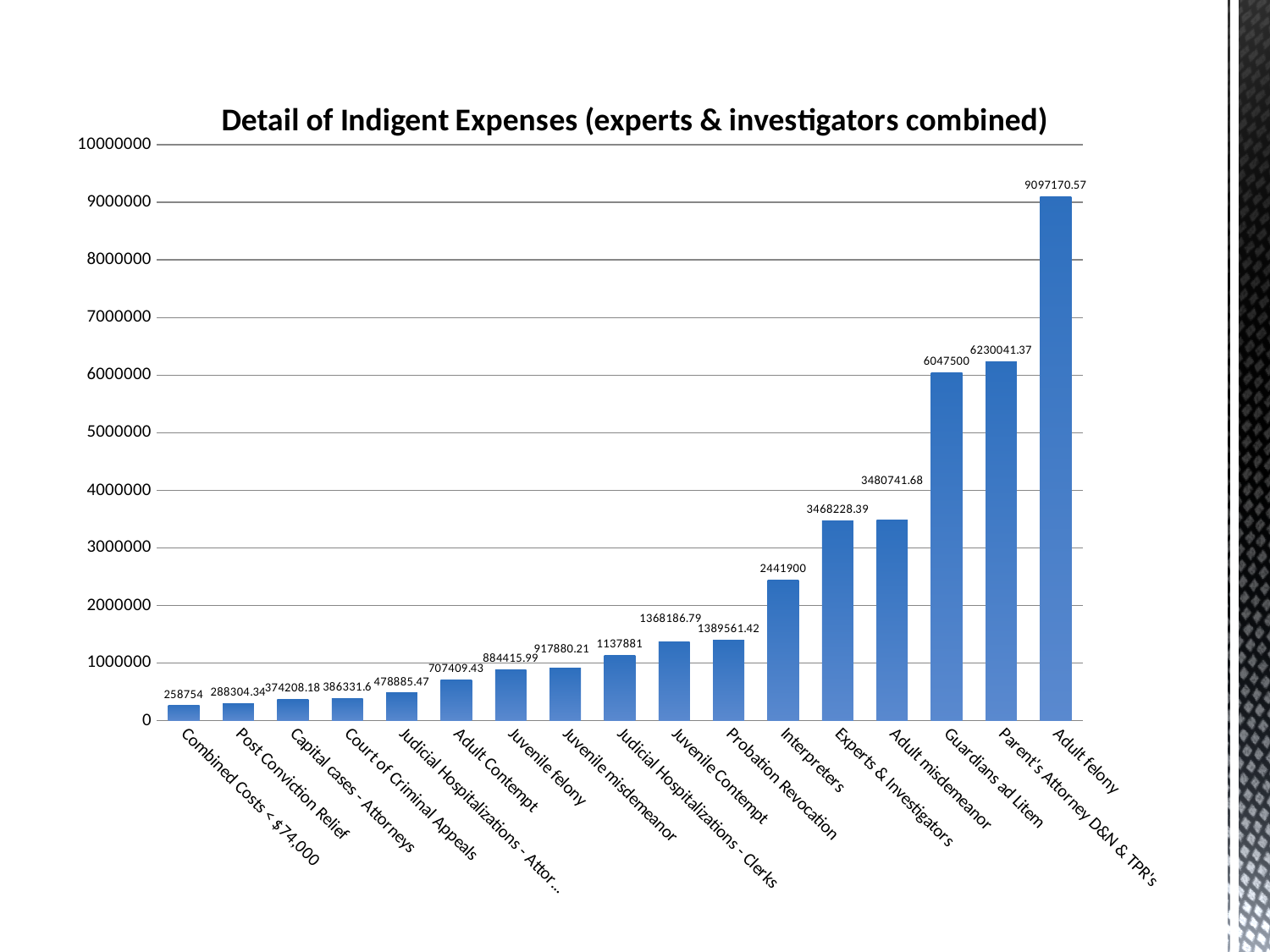
Do the values rise or fall from left to right along the x axis? rise What is the value for Post Conviction Relief? 288304.34 What is the value for Adult felony? 9097170.57 What is the value for Guardians ad Litem? 6047500 How many categories are shown on the x axis? 17 Which category has the lowest value? Combined Costs < $74,000 What is the difference between the values for Adult felony and Guardians ad Litem? 3049670.57 What is the value for Interpreters? 2441900 What kind of chart is this? bar chart Which category has the highest value? Adult felony Which is larger, the value for Parent's Attorney D&N & TPR's or the value for Guardians ad Litem? Parent's Attorney D&N & TPR's Is the value for Interpreters greater or less than 2000000? greater